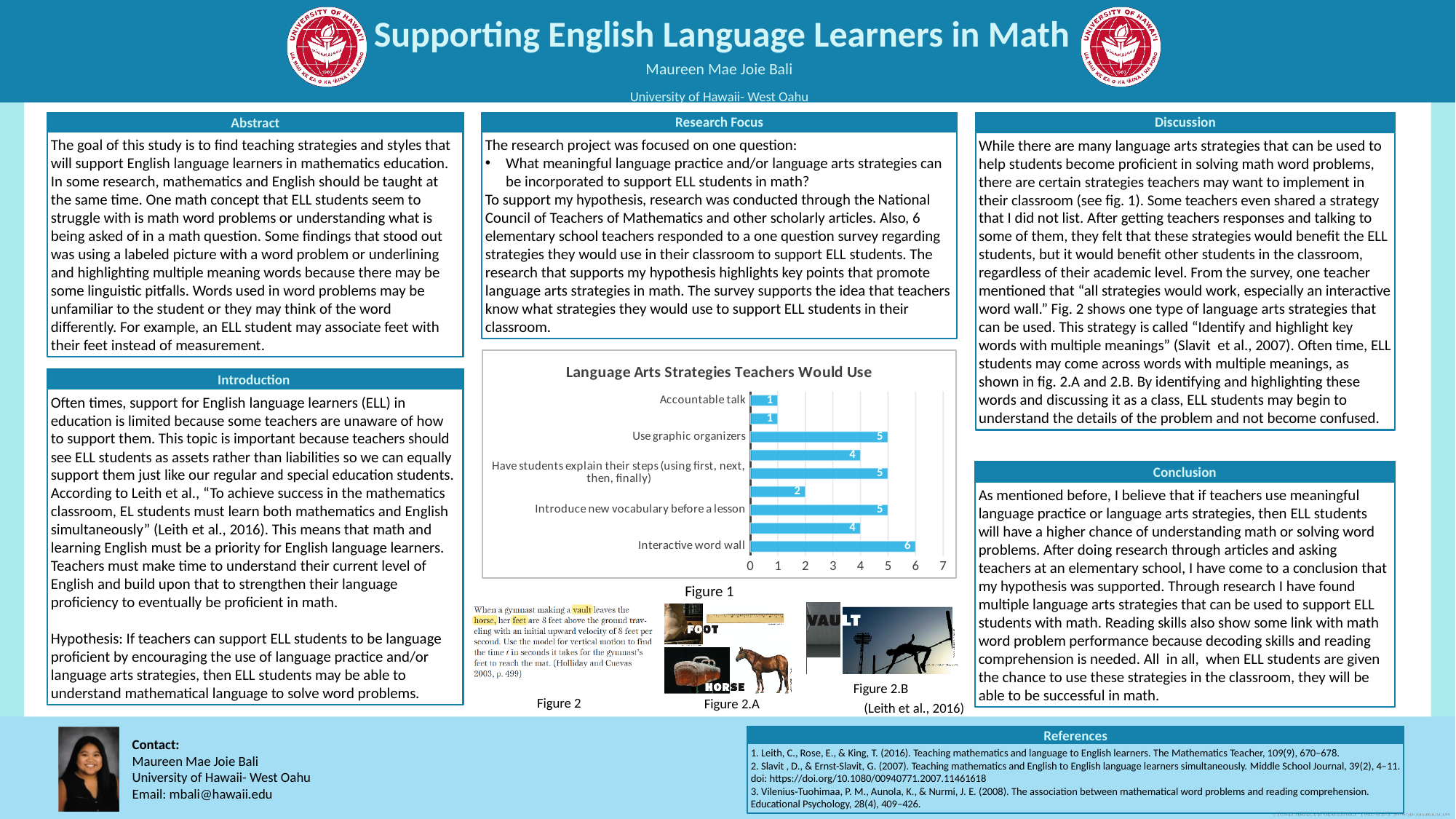
How many bars are plotted in the chart? 9 In the chart, what is the value for Have students explain their steps (using first, next, then, finally)? 5 What is the title of the chart on the slide? Language Arts Strategies Teachers Would Use What is the difference between the values for Interactive word wall and Accountable talk? 5 Which has a larger value, Use graphic organizers or Accountable talk? Use graphic organizers In the chart, what is the value for Accountable talk? 1 In the chart, what is the value for Use graphic organizers? 5 In the chart, what is the value for Introduce new vocabulary before a lesson? 5 What kind of chart is shown on the slide? bar chart Which strategy has the highest value in the chart? Interactive word wall In the chart, what is the value for Interactive word wall? 6 What is the highest value shown on the chart's horizontal axis? 7